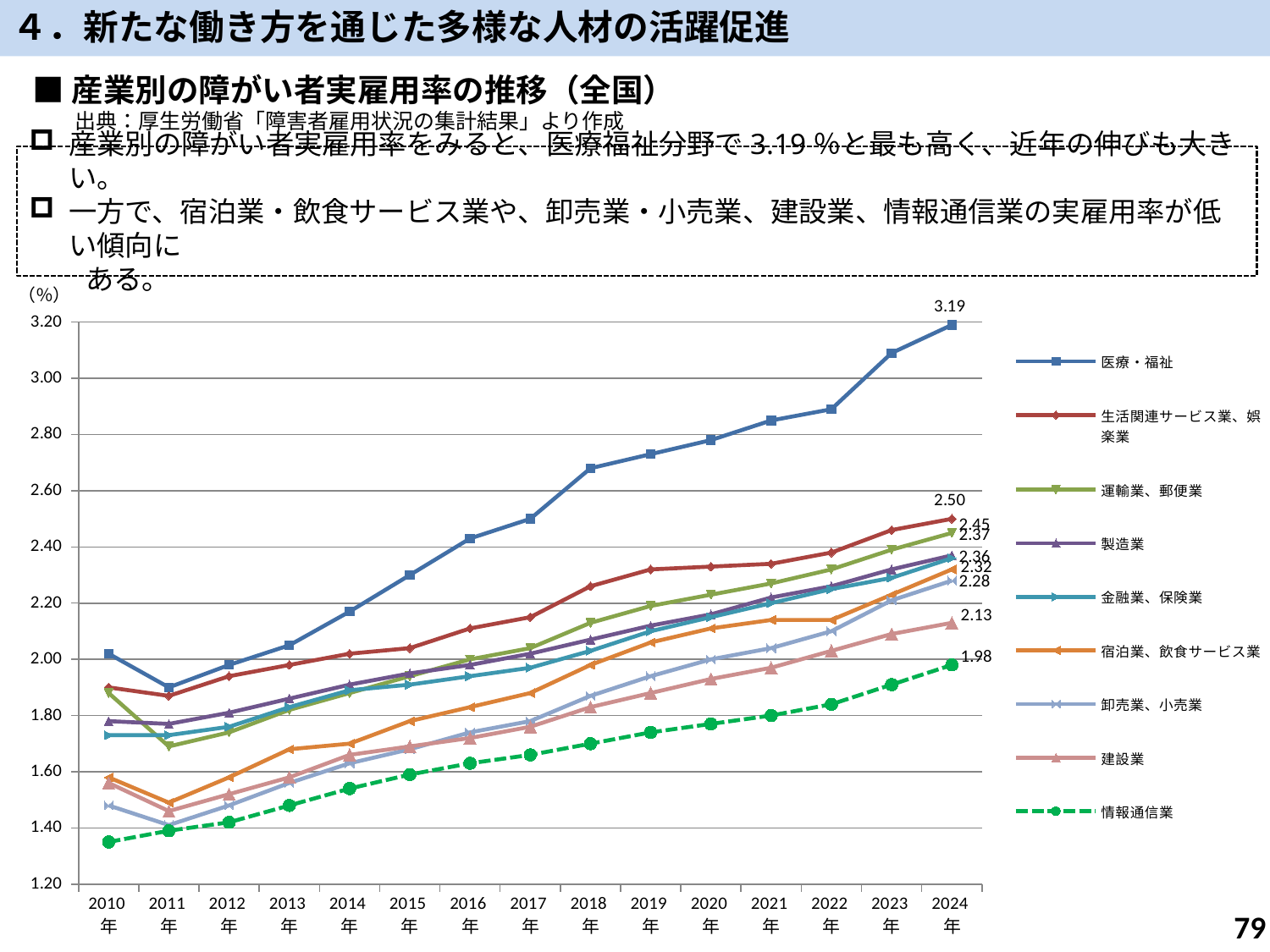
How many series does the legend list? 9 Is the value for 情報通信業 in 2010年 greater or less than 1.40? less Is the value for 医療・福祉 in 2010年 greater or less than 2.20? less What is the value for 情報通信業 in 2024年? 1.98 Which series has the highest value in 2024年? 医療・福祉 What is the value for 医療・福祉 in 2024年? 3.19 What is the difference between the 2024年 values for 医療・福祉 and 情報通信業? 1.21 In 2024年, which is larger: 生活関連サービス業、娯楽業 or 建設業? 生活関連サービス業、娯楽業 What kind of chart is shown on the slide? line chart Which series has the lowest value in 2024年? 情報通信業 How many years are shown on the x axis? 15 What is the value for 建設業 in 2024年? 2.13